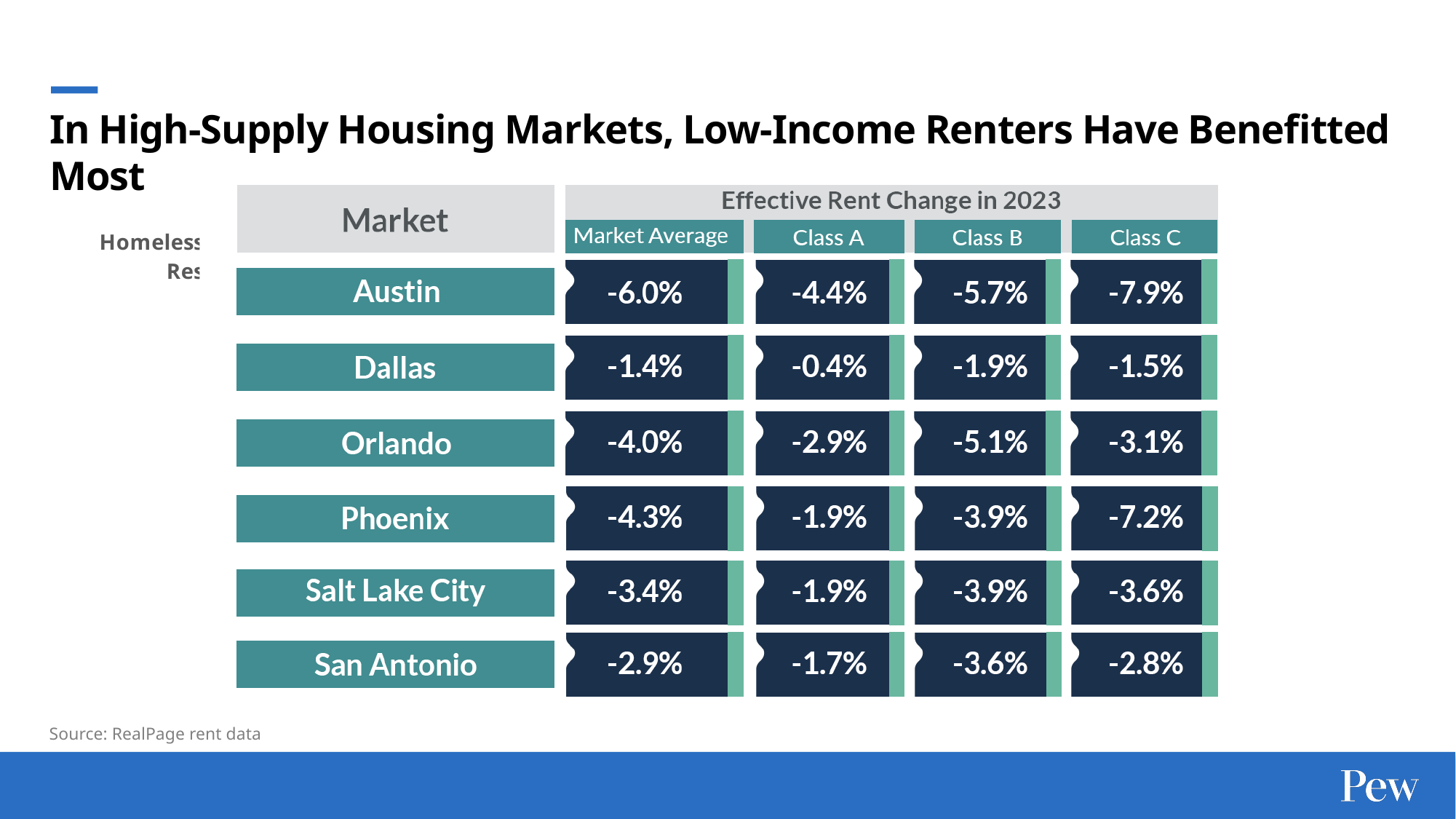
What is the source cited for the data? RealPage rent data How many markets are listed in the table? 6 What is the Class C effective rent change in 2023 for Phoenix? -7.2% What is the Class A effective rent change in 2023 for Dallas? -0.4% How many rent change columns are shown under 'Effective Rent Change in 2023'? 4 What is the Market Average effective rent change in 2023 for Austin? -6.0% What is the title of the slide? In High-Supply Housing Markets, Low-Income Renters Have Benefitted Most What is the difference between Austin's Class C and Class A effective rent change in 2023? 3.5 percentage points Which is the larger decline for San Antonio in 2023: Class B or Class C? Class B What is the Class B effective rent change in 2023 for Orlando? -5.1% Which market has the largest decline in Market Average effective rent in 2023? Austin Which market has the smallest decline in Class C effective rent in 2023? Dallas